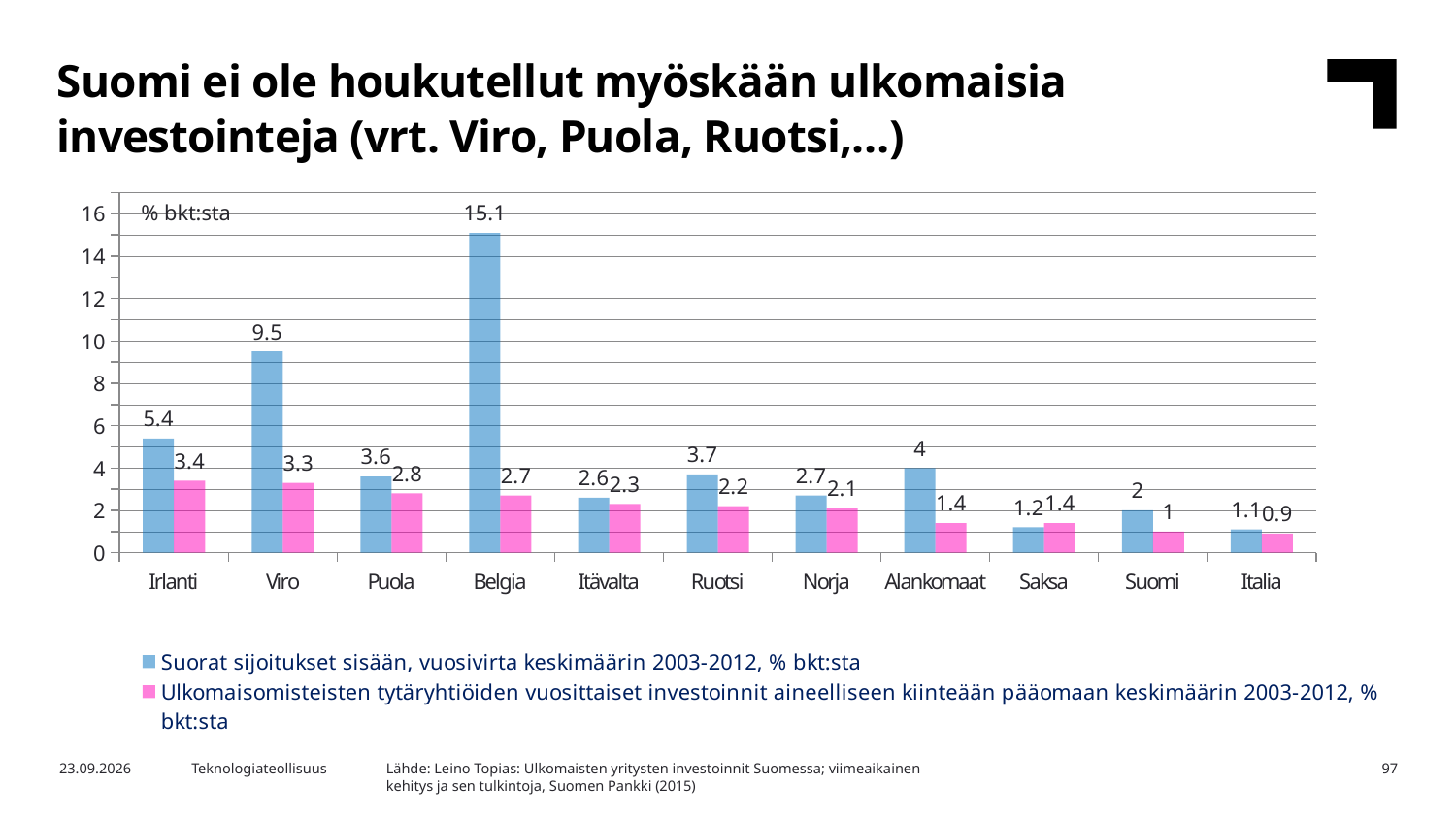
What unit label is shown at the top left of the chart's plot area? % bkt:sta What kind of chart is shown on the slide? Bar chart What is the value of 'Suorat sijoitukset sisään, vuosivirta keskimäärin 2003-2012, % bkt:sta' for Belgia? 15.1 Which is larger for Suomi: 'Suorat sijoitukset sisään' or 'Ulkomaisomisteisten tytäryhtiöiden vuosittaiset investoinnit'? Suorat sijoitukset sisään How many series does the chart's legend list? 2 Which country has the highest value for 'Suorat sijoitukset sisään, vuosivirta keskimäärin 2003-2012, % bkt:sta'? Belgia Is the 'Suorat sijoitukset sisään' value for Irlanti greater or less than 4? greater What is the difference between the 'Suorat sijoitukset sisään' values for Belgia and Viro? 5.6 What is the value of 'Suorat sijoitukset sisään, vuosivirta keskimäärin 2003-2012, % bkt:sta' for Viro? 9.5 Which country has the lowest value for 'Ulkomaisomisteisten tytäryhtiöiden vuosittaiset investoinnit aineelliseen kiinteään pääomaan keskimäärin 2003-2012, % bkt:sta'? Italia What is the value of 'Ulkomaisomisteisten tytäryhtiöiden vuosittaiset investoinnit aineelliseen kiinteään pääomaan keskimäärin 2003-2012, % bkt:sta' for Suomi? 1 How many countries are shown on the x axis of the chart? 11